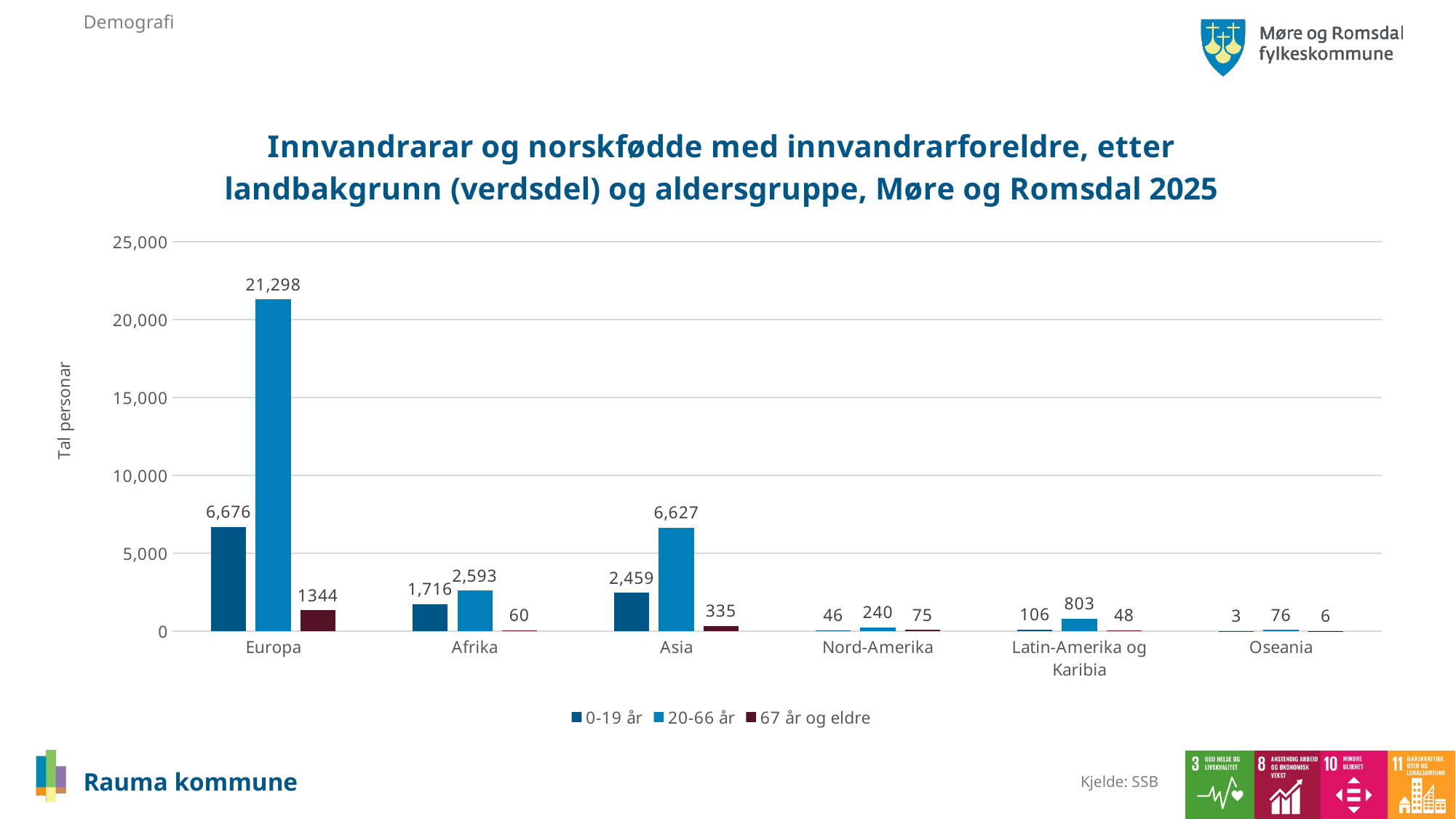
Which category has the lowest value in the 0-19 år series? Oseania What is the value for Europa in the 20-66 år series? 21,298 What is the value for Asia in the 0-19 år series? 2,459 Is the 0-19 år value for Europa greater or less than 5,000? greater What is the difference between the 20-66 år and 0-19 år values for Europa? 14,622 Which category has the highest value in the 20-66 år series? Europa How many series does the legend list? 3 Which is larger: the 20-66 år value for Asia or the 20-66 år value for Afrika? Asia What is the value for Latin-Amerika og Karibia in the 20-66 år series? 803 What is the value for Oseania in the 67 år og eldre series? 6 What kind of chart is shown on the slide? Bar chart How many categories (world regions) are shown on the x axis? 6